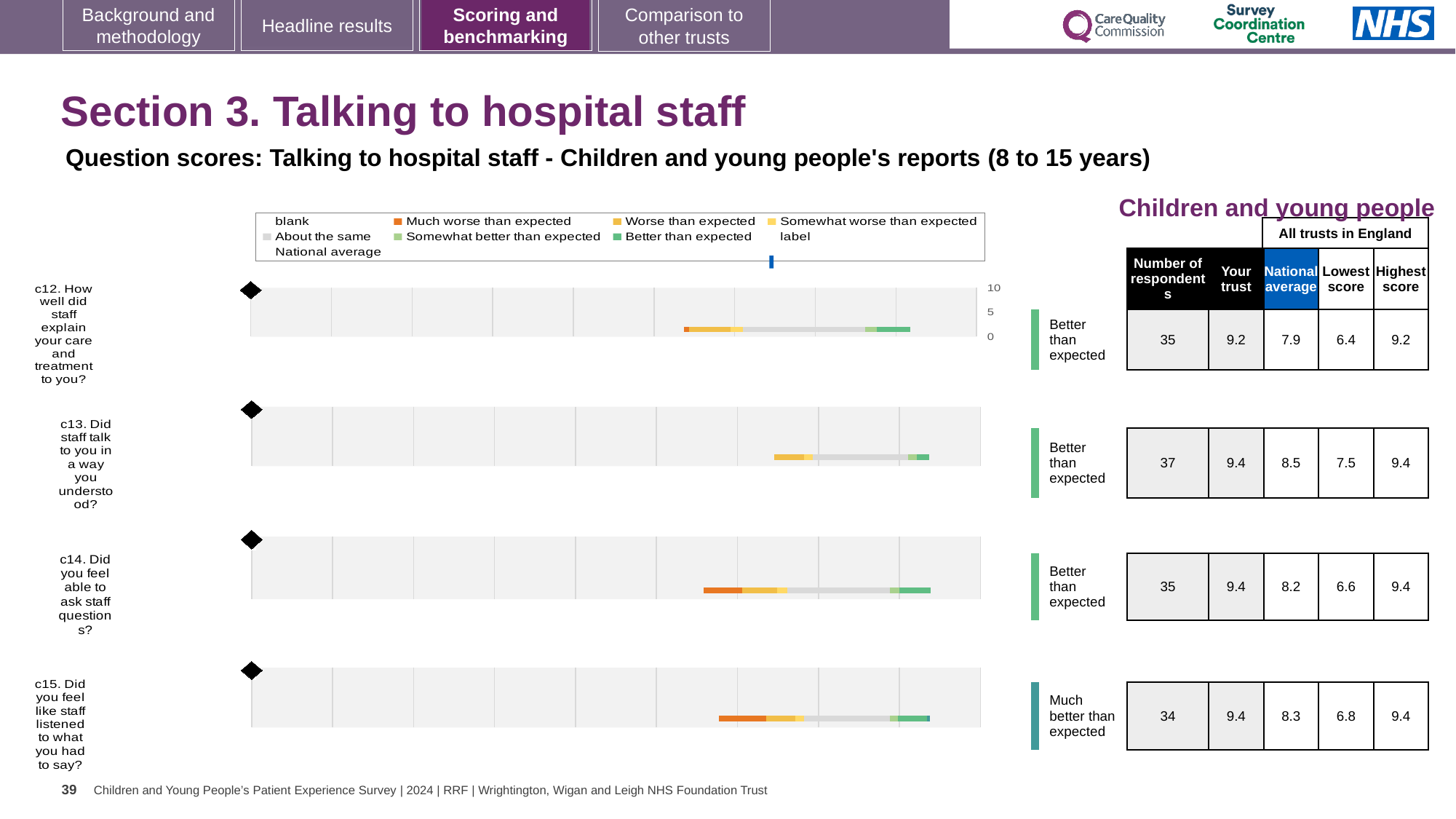
How many questions are shown on the slide? 4 What kind of chart is used to show the benchmark bands for each question? Bar chart What is the national average score for c13 (Did staff talk to you in a way you understood?)? 8.5 What is the 'Your trust' score for c12 (How well did staff explain your care and treatment to you?)? 9.2 Which has the higher national average score: c14 or c15? c15 For c12, how much higher is the 'Your trust' score than the national average? 1.3 Which question has the highest national average score? c13 What is the lowest score among all trusts in England for c14 (Did you feel able to ask staff questions?)? 6.6 What benchmark category is shown for c15 (Did you feel like staff listened to what you had to say?)? Much better than expected For c14, what is the difference between the highest score and the lowest score among all trusts in England? 2.8 How many respondents answered c15 (Did you feel like staff listened to what you had to say?)? 34 Which question has the lowest 'Lowest score' among all trusts in England? c12